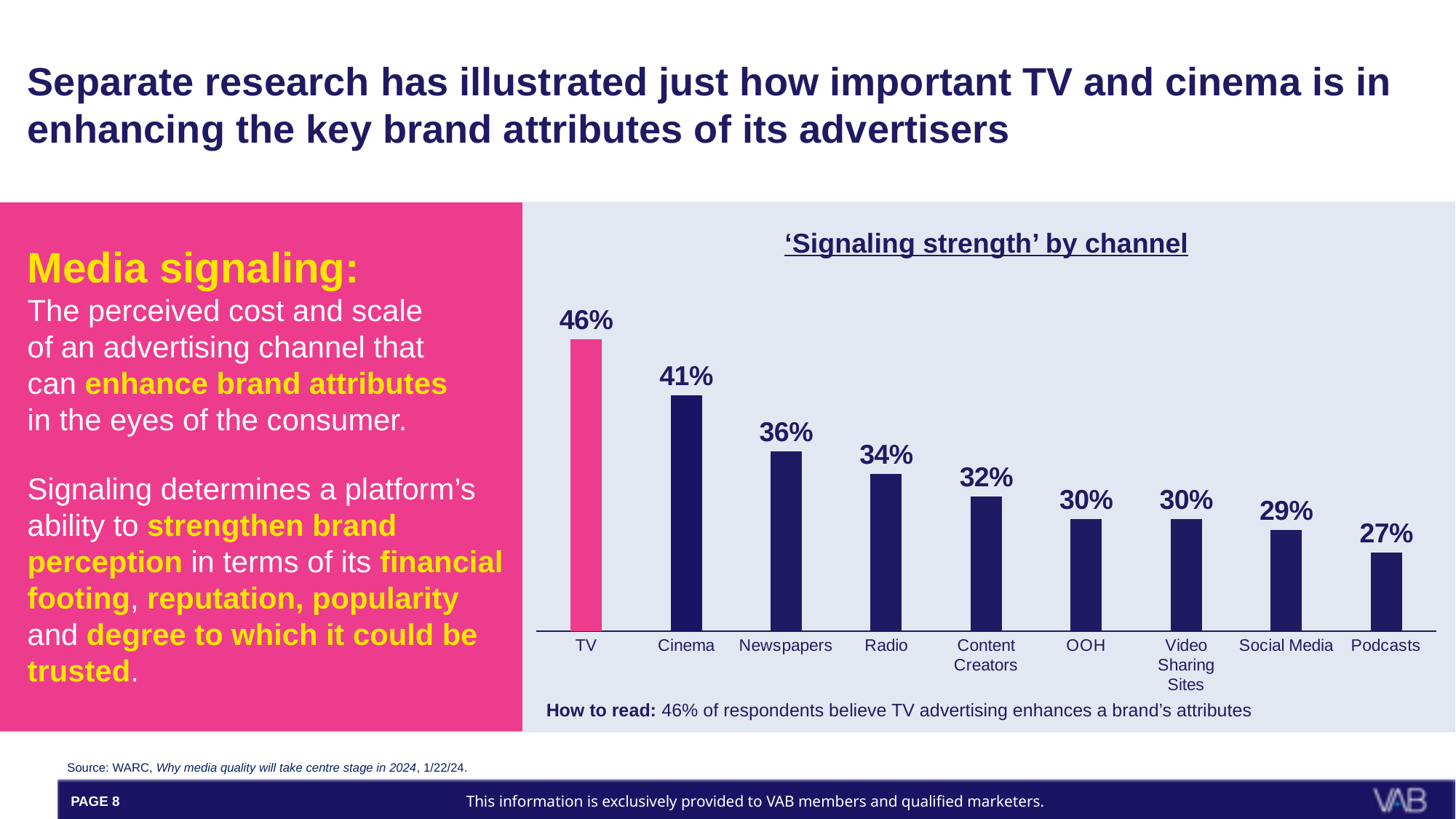
How many channels are shown in the chart? 9 What is the signaling strength value for Podcasts? 27% What is the signaling strength value for TV? 46% Which has a higher signaling strength, Radio or Social Media? Radio Which channel has the lowest signaling strength? Podcasts What is the signaling strength value for Content Creators? 32% What is the title of the chart? 'Signaling strength' by channel What is the signaling strength value for Cinema? 41% Which channel has the highest signaling strength? TV What is the difference in signaling strength between Newspapers and Radio? 2% What type of chart is shown on the slide? Bar chart What is the difference in signaling strength between TV and Cinema? 5%